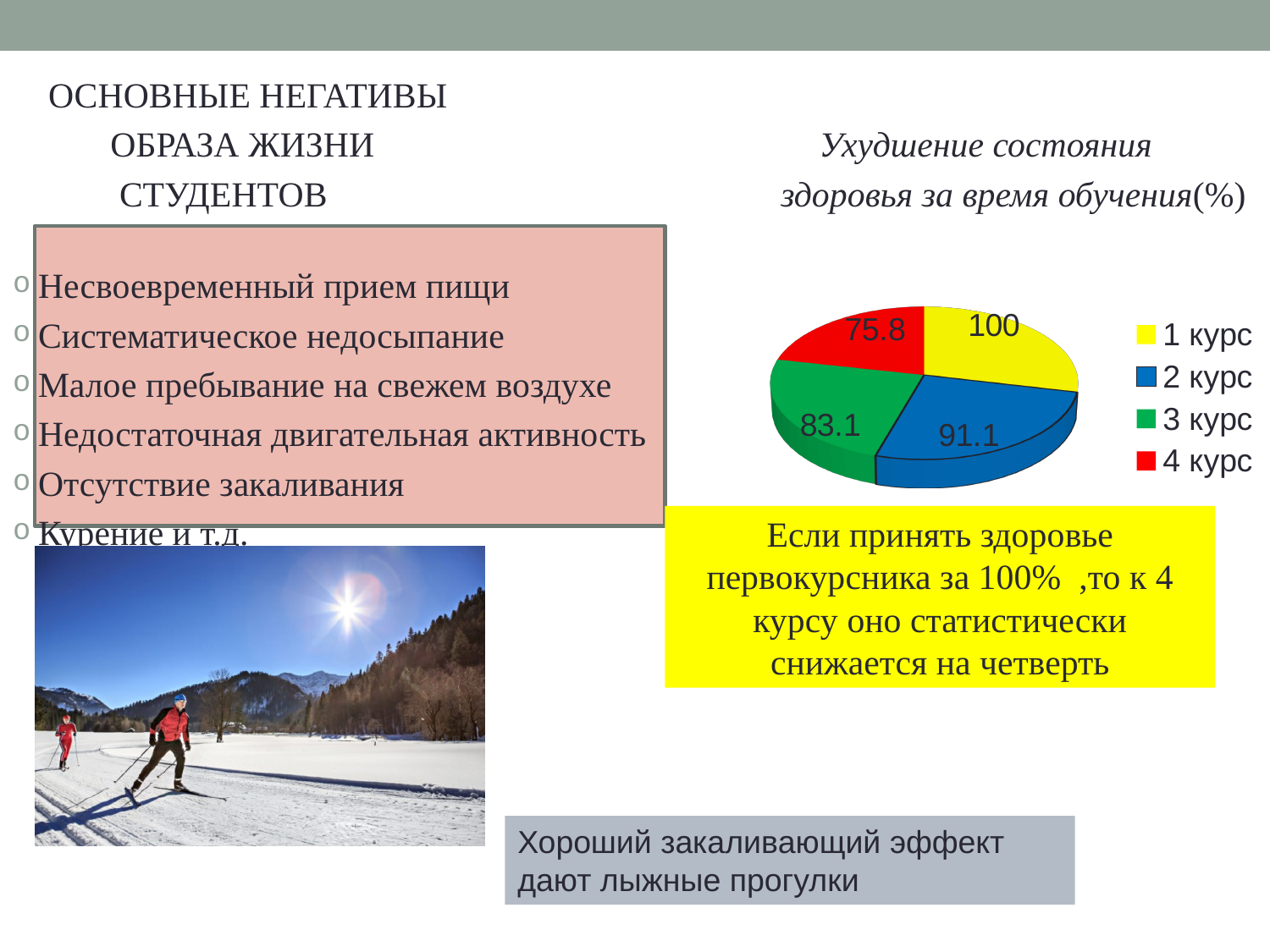
How many slices does the pie chart have? 4 Which is larger, the value for 2 курс or the value for 3 курс? 2 курс What is the value for 2 курс in the pie chart? 91.1 What is the value for 4 курс in the pie chart? 75.8 What is the value for 3 курс in the pie chart? 83.1 Which category has the lowest value in the pie chart? 4 курс Which category has the highest value in the pie chart? 1 курс What is the value for 1 курс in the pie chart? 100 What type of chart is shown on the slide? pie chart What is the difference between the values for 2 курс and 3 курс? 8 What colour is the slice for 3 курс in the pie chart? green What is the difference between the values for 1 курс and 4 курс? 24.2